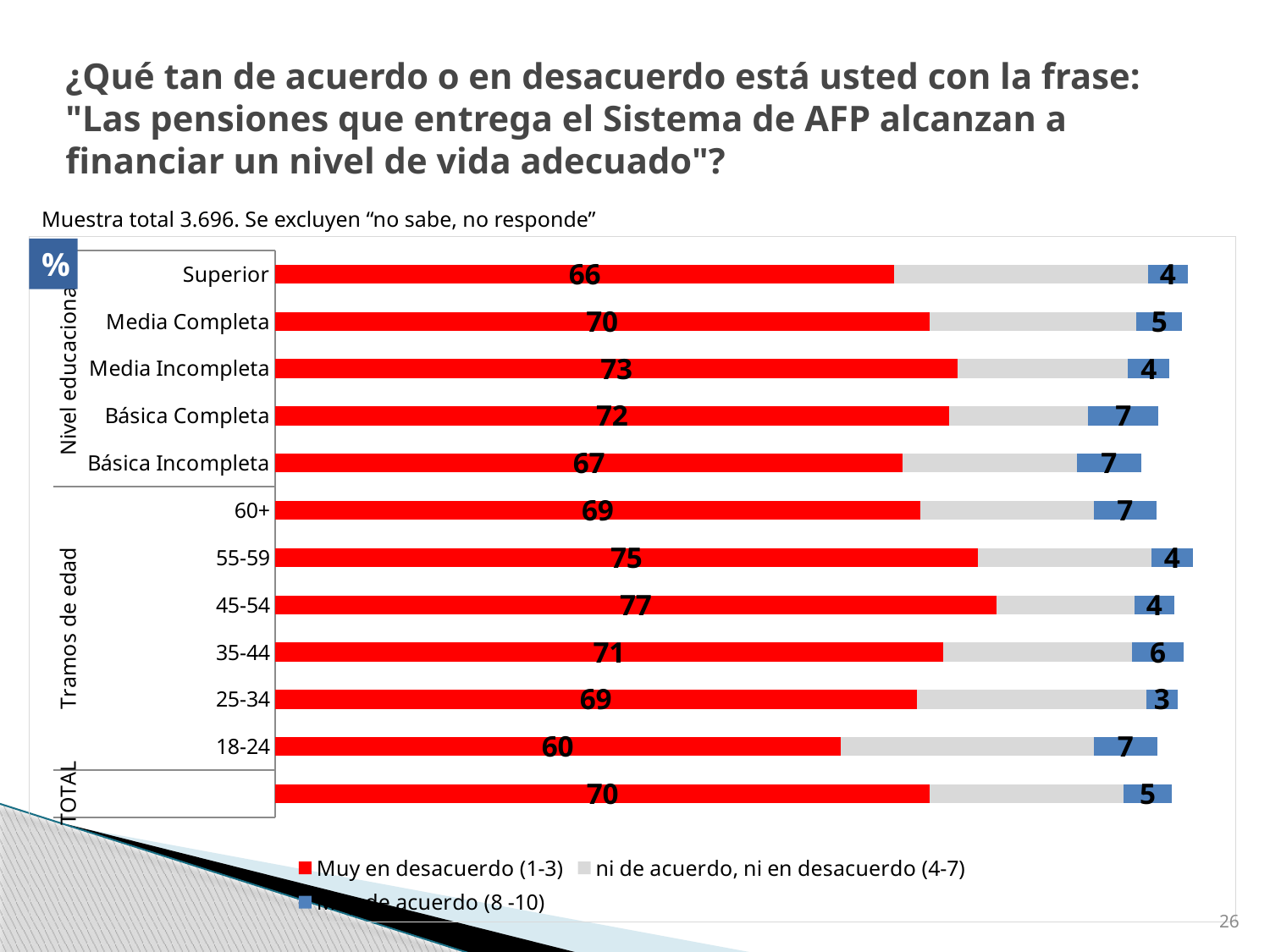
What kind of chart is shown on the slide? Stacked bar chart How many series does the legend list? 3 How many categories are shown on the chart? 12 What is the value of "Muy de acuerdo (8-10)" for the 25-34 age group? 3 What is the value of "Muy de acuerdo (8-10)" for the 18-24 age group? 7 What is the value of "Muy en desacuerdo (1-3)" for TOTAL? 70 Which has a larger "Muy en desacuerdo (1-3)" value, Media Incompleta or Superior? Media Incompleta Which category has the lowest value for "Muy en desacuerdo (1-3)"? 18-24 What is the difference between the "Muy en desacuerdo (1-3)" values for 45-54 and 18-24? 17 Which category has the lowest value for "Muy de acuerdo (8-10)"? 25-34 Which category has the highest value for "Muy en desacuerdo (1-3)"? 45-54 What is the value of "Muy en desacuerdo (1-3)" for the 45-54 age group? 77